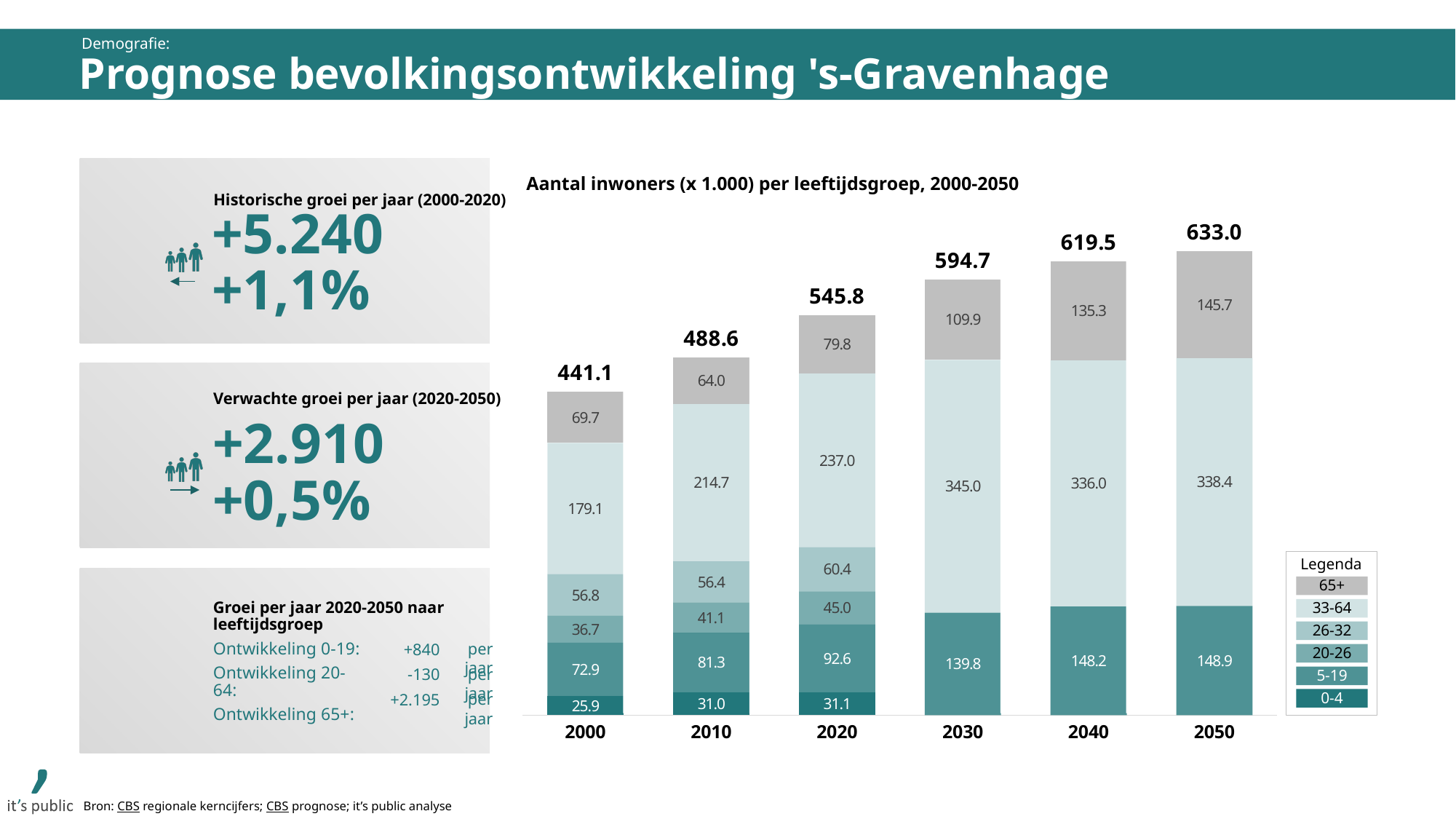
Which year has the lowest total number of inhabitants? 2000 What is the value for the 0-4 age group in 2010? 31.0 What is the value for the 33-64 age group in 2030? 345.0 How many age groups does the legend list? 6 What is the value for the 65+ age group in 2020? 79.8 What is the difference between the total for 2050 and the total for 2000? 191.9 Do the bar totals rise or fall from 2000 to 2050? rise How many years are shown along the x axis of the chart? 6 Which year has the larger value for the 65+ age group, 2040 or 2050? 2050 What kind of chart is shown on the slide? stacked bar chart What is the total number of inhabitants (x 1.000) shown for 2050? 633.0 Which year has the highest total number of inhabitants? 2050